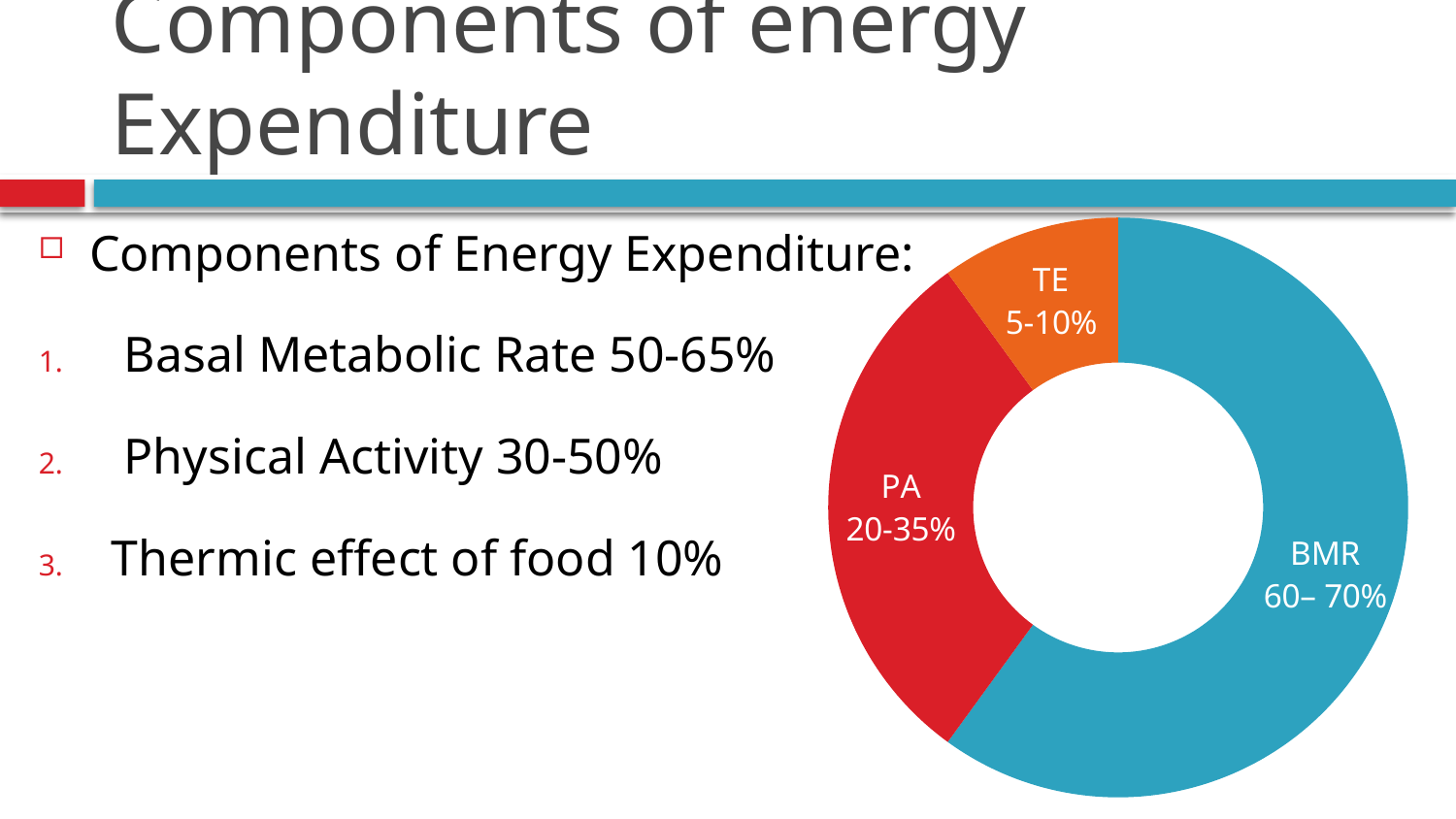
Which slice is larger in the chart, BMR or PA? BMR How many slices does the doughnut chart have? 3 Which slice is larger in the chart, PA or TE? PA What range is printed on the TE slice of the chart? 5-10% Which slice of the chart is the smallest? TE What colour is the PA slice in the chart? Red What range is printed on the PA slice of the chart? 20-35% What range is printed on the BMR slice of the chart? 60– 70% What colour is the BMR slice in the chart? Blue What kind of chart is shown on the slide? Doughnut (pie) chart Which slice of the chart is the largest? BMR